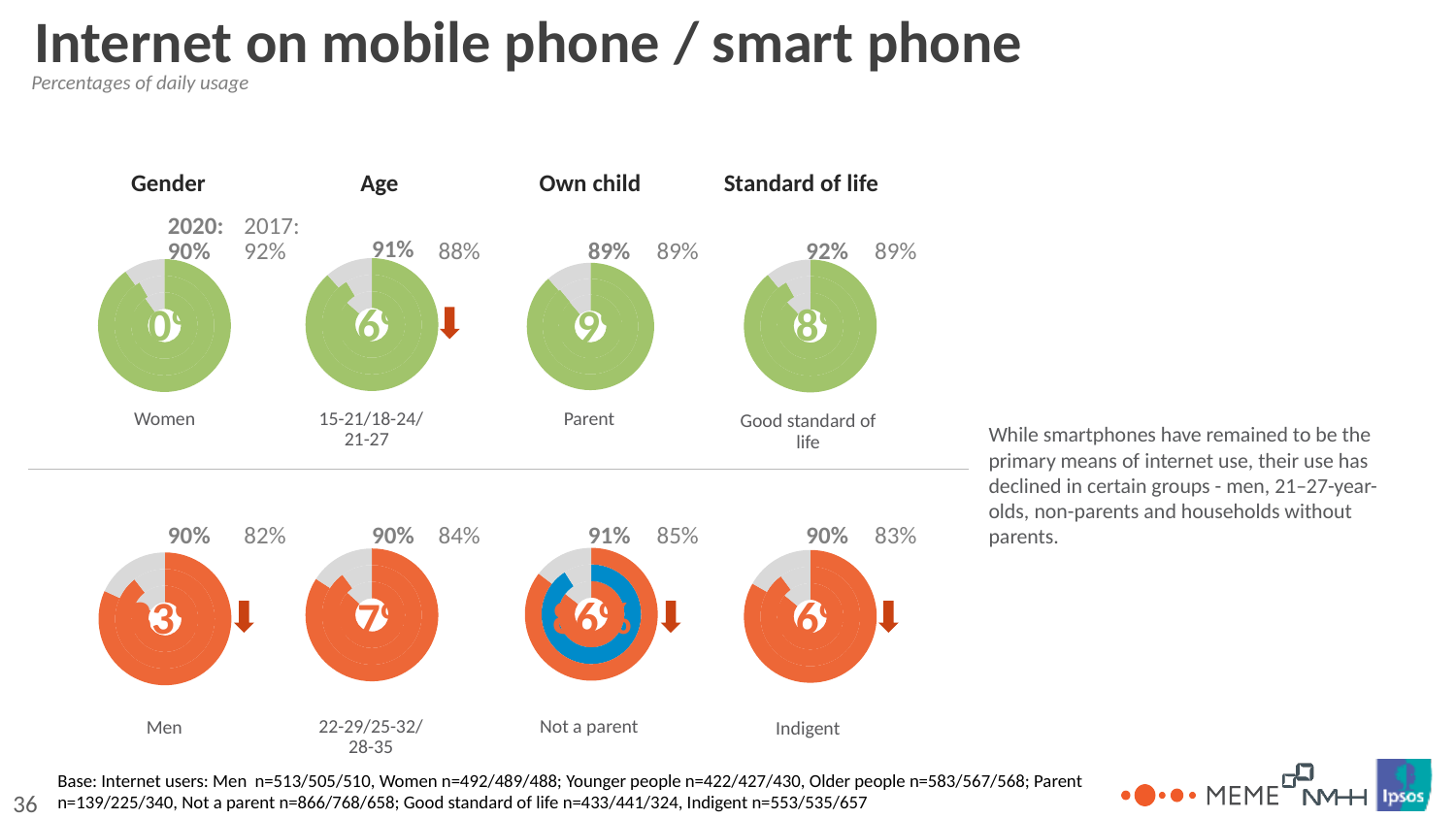
In the Women chart, is the 2020 value larger or smaller than the 2017 value? smaller In the Men chart, what is the difference between the 2020 and 2017 percentages? 8 percentage points What type of chart is used to show each group's percentage on the slide? Donut (pie) chart In the Men chart, what was the 2017 percentage of daily usage? 82% In the Women chart, what is the 2020 percentage of daily usage? 90% In the Good standard of life chart, what is the difference between the 2020 and 2017 values? 3 percentage points In the Indigent chart, what was the 2017 percentage? 83% How many donut charts are shown on the slide? 8 Which group has the lowest 2017 percentage across all the charts on the slide? Men In the Parent chart, did the percentage change between 2017 and 2020? No, it stayed at 89% In the Not a parent chart, what is the 2020 percentage? 91% Which group has the highest 2020 percentage across all the charts on the slide? Good standard of life